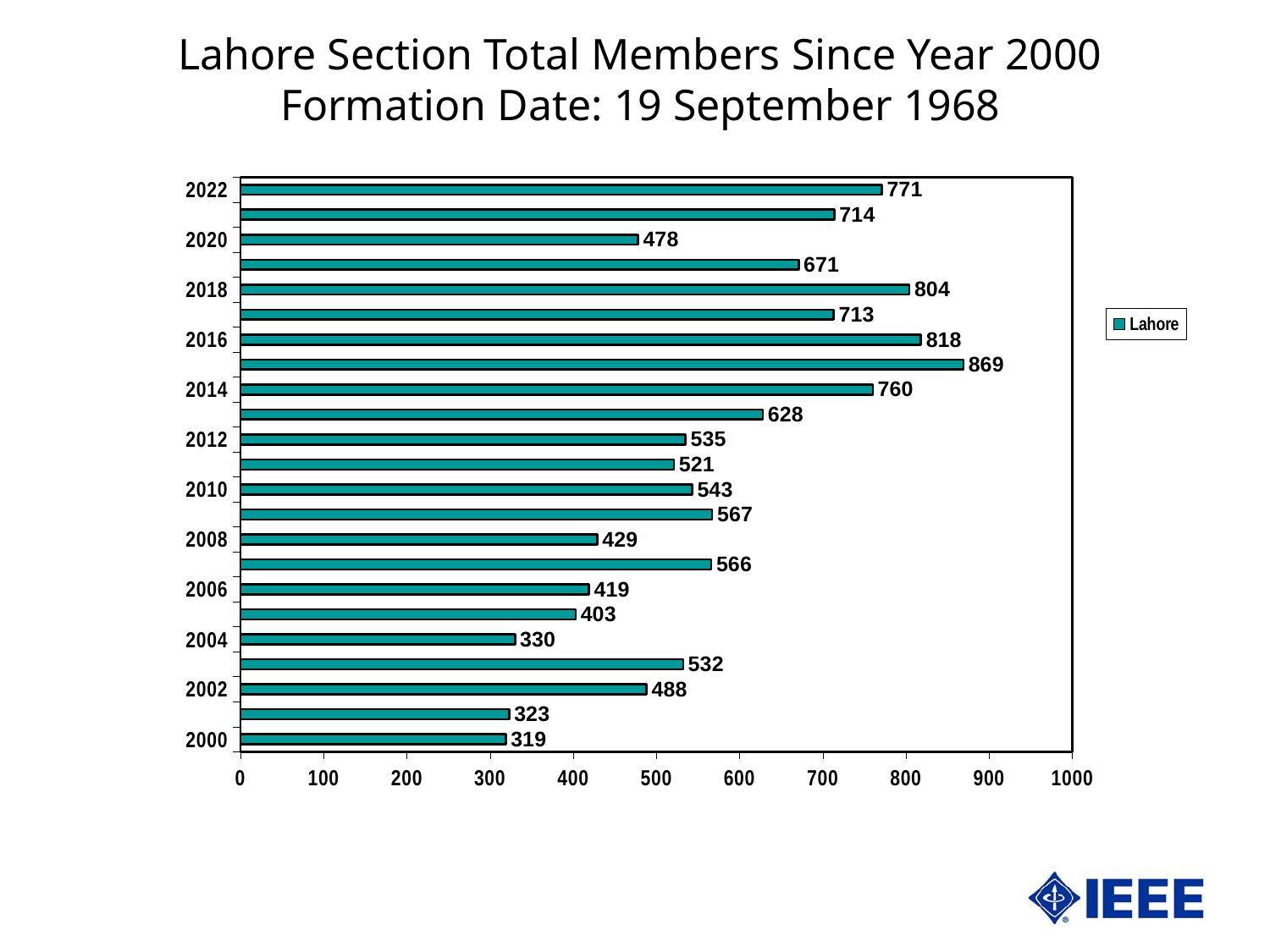
What is the value for 2022? 771 What is the value for 2016? 818 What is the highest value shown on the chart? 869 Is the value for 2010 greater or less than 500? greater What is the difference between the values for 2018 and 2020? 326 How many series does the legend list? 1 What kind of chart is shown? bar chart What is the value for 2020? 478 Which year has the lowest value? 2000 What is the value for 2004? 330 Which is larger, the value for 2014 or the value for 2012? 2014 How many bars are plotted on the chart? 23